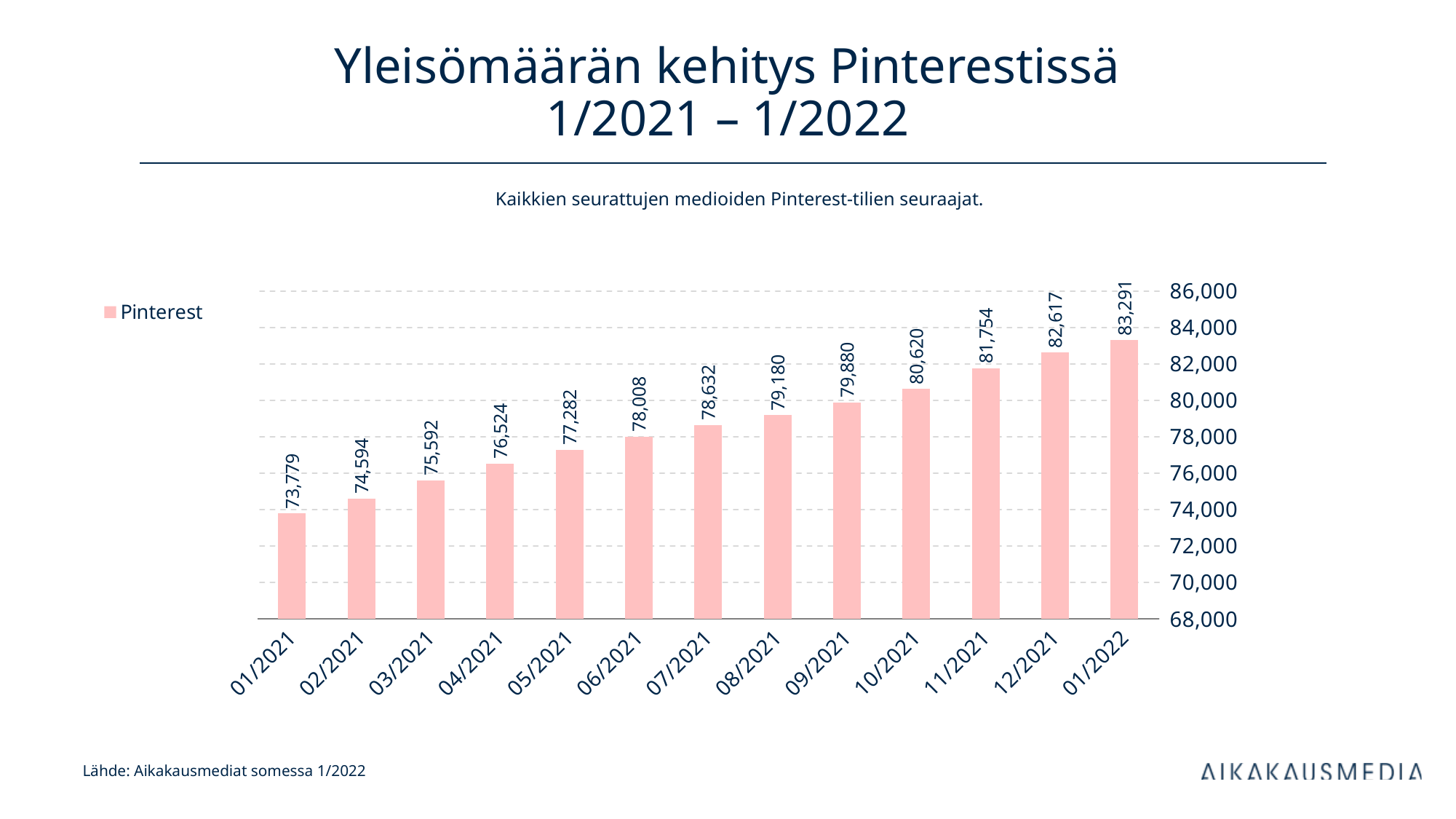
What is the difference between the values for 01/2022 and 01/2021? 9,512 Which month has the lowest value? 01/2021 Which month has the highest value? 01/2022 How many months are shown on the x axis? 13 What is the value for 01/2022? 83,291 What is the value for 07/2021? 78,632 What kind of chart is shown on the slide? bar chart Which is larger, the value for 05/2021 or the value for 09/2021? 09/2021 Is the value for 10/2021 greater or less than 80,000? greater Do the values rise or fall from 01/2021 to 01/2022? rise What is the difference between the values for 12/2021 and 11/2021? 863 What is the value for 01/2021? 73,779